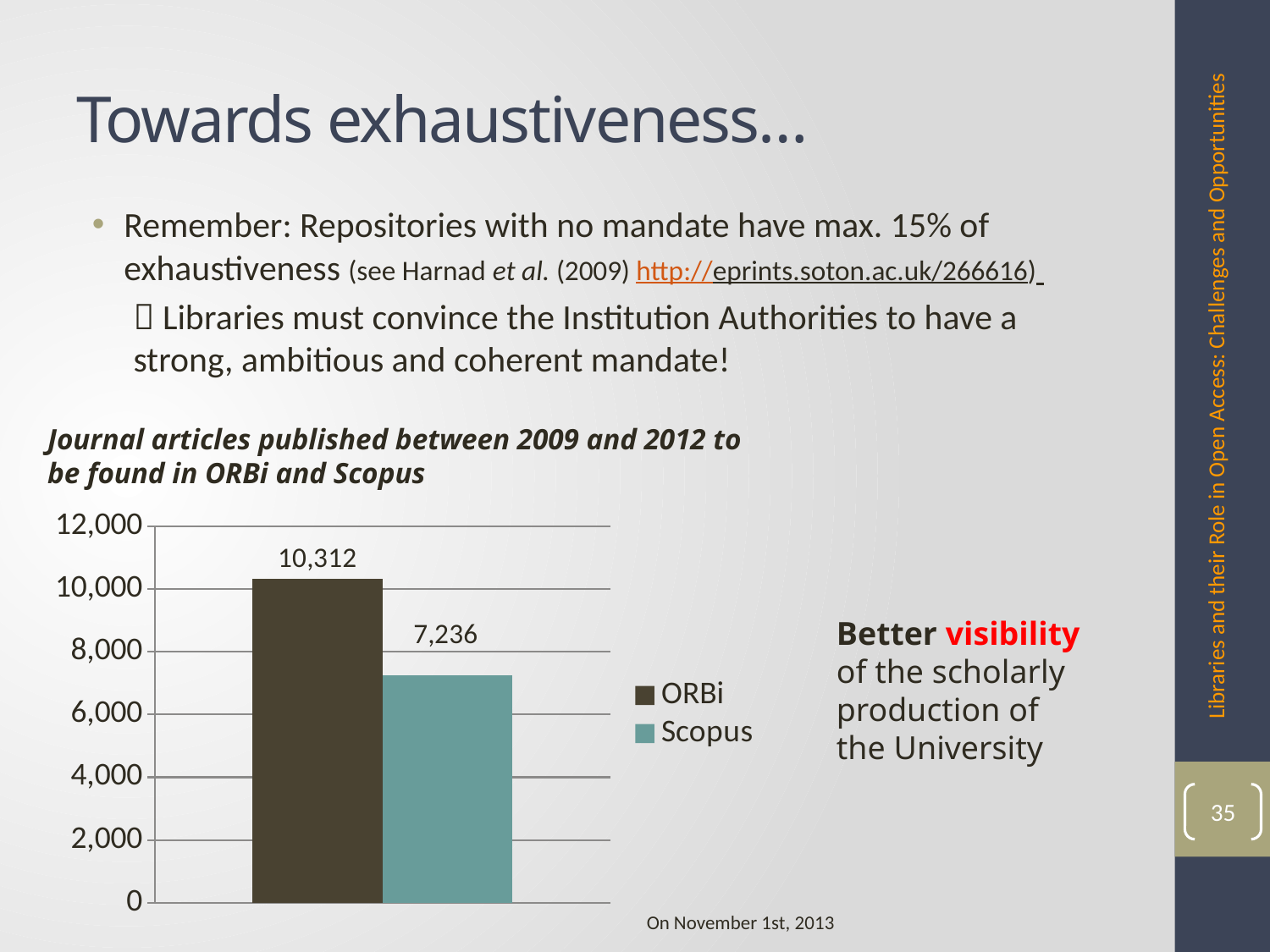
Is the value for ORBi greater or less than 10,000? greater Is the value for Scopus greater or less than 8,000? less What is the value for ORBi? 10,312 What is the title of the chart? Journal articles published between 2009 and 2012 to be found in ORBi and Scopus Which series has the lower value? Scopus How many bars are plotted in the chart? 2 Which series has the higher value, ORBi or Scopus? ORBi What is the difference between the ORBi and Scopus values? 3,076 What kind of chart is shown on the slide? bar chart What is the maximum value shown on the vertical axis? 12,000 How many series does the legend list? 2 What is the value for Scopus? 7,236